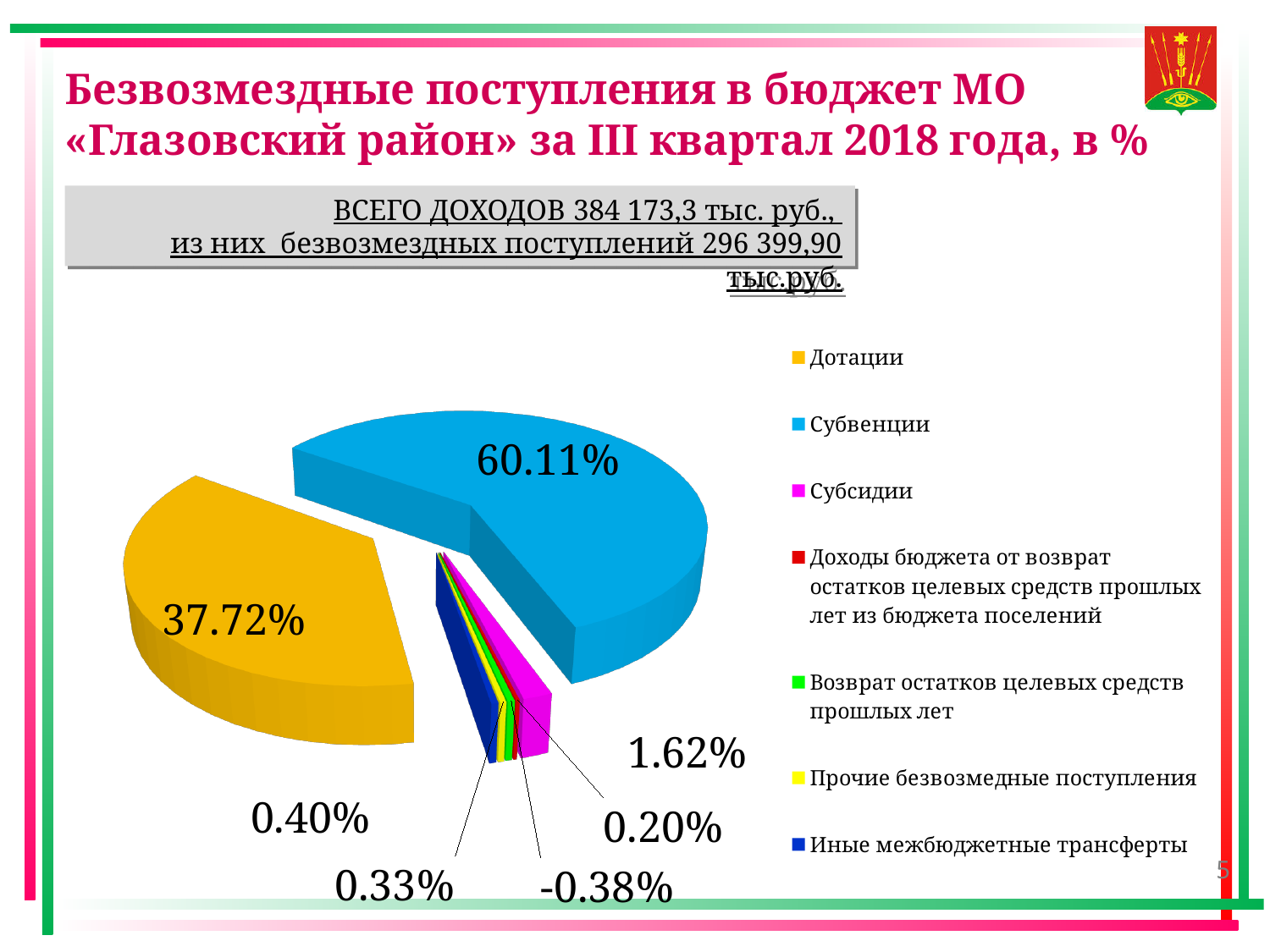
What share of the pie does Дотации have? 37.72% How many categories does the legend list? 7 What share of the pie does Субвенции have? 60.11% Which category has the lowest value in the chart? Возврат остатков целевых средств прошлых лет What colour is the slice for Субвенции? Blue What value is shown for Иные межбюджетные трансферты? 0.40% Which is larger, the share of Дотации or the share of Субсидии? Дотации Which category has the largest share of the pie? Субвенции What share of the pie does Субсидии have? 1.62% What kind of chart is shown on the slide? Pie chart What value is shown for Возврат остатков целевых средств прошлых лет? -0.38% What is the difference between the shares of Субвенции and Дотации? 22.39%